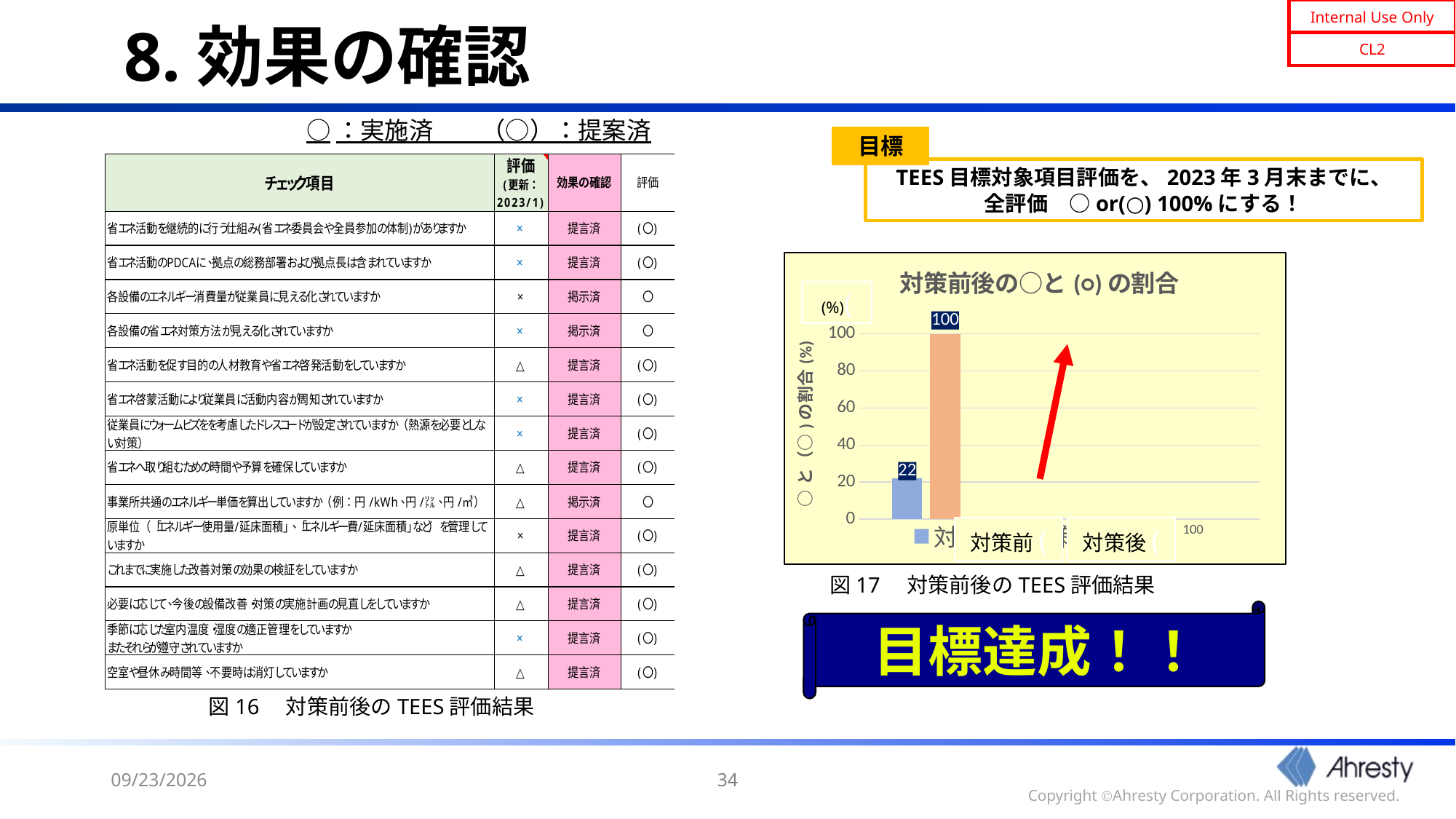
What is the maximum value shown on the chart's vertical axis? 100 In the chart, what is the value for 対策後? 100 Which bar in the chart is higher, 対策前 or 対策後? 対策後 In the chart, what is the value for 対策前? 22 How many bars are plotted in the chart? 2 Which category has the highest value in the chart? 対策後 Is the value for 対策後 greater or less than 80? greater Which category has the lowest value in the chart? 対策前 Is the value for 対策前 greater or less than 40? less What type of chart is shown in Figure 17 (対策前後のTEES評価結果)? bar chart What is the difference between the 対策後 and 対策前 values in the chart? 78 What is the title of the chart in Figure 17? 対策前後の○と(○)の割合